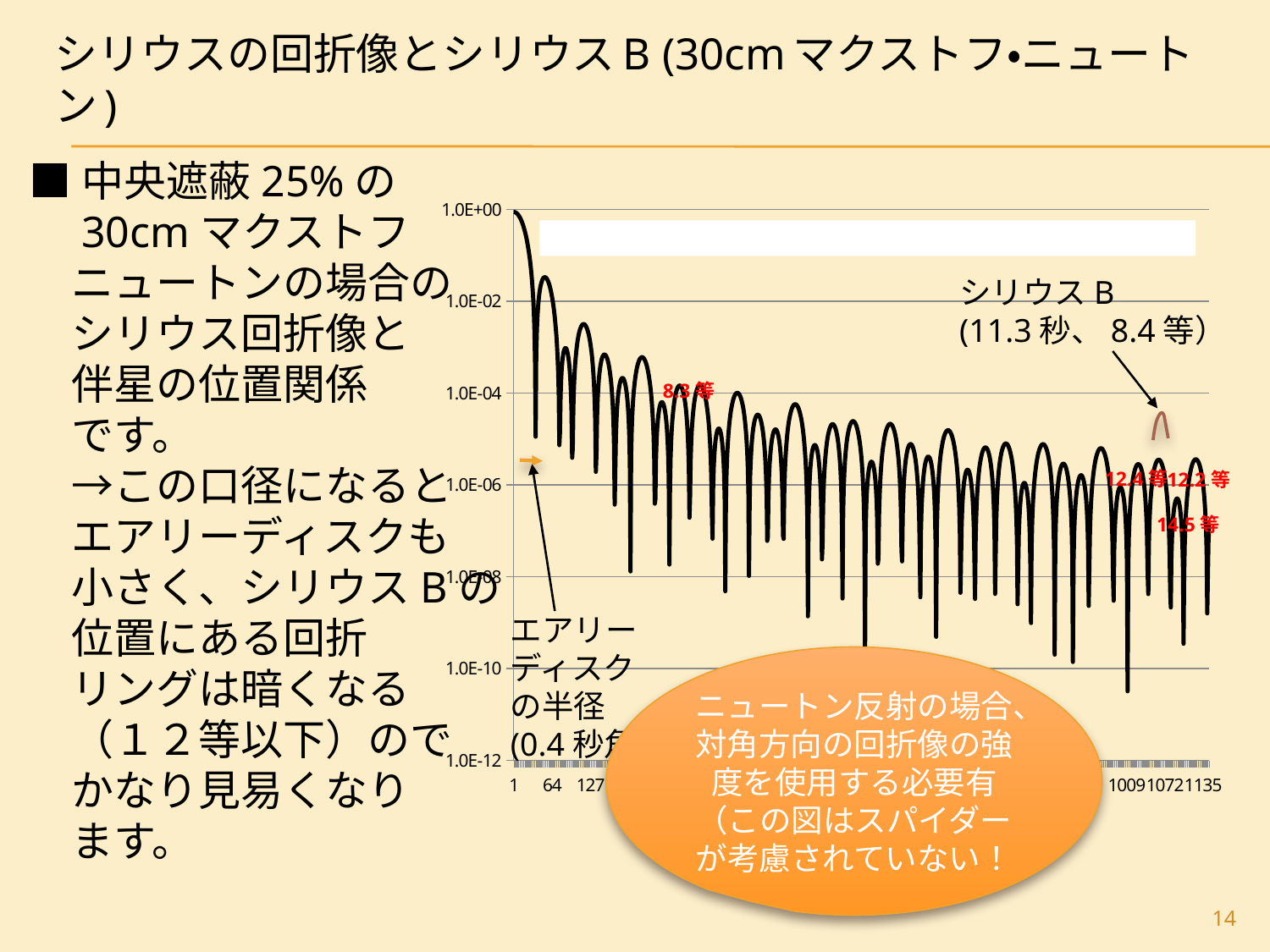
What is the highest value shown on the y axis of the chart? 1.0E+00 What kind of chart is shown on the slide? line chart Are the peaks of the curve near the position marked シリウス B greater or less than 1.0E-04? less According to the annotation on the chart, what is the separation and magnitude of シリウス B? 11.3 秒、8.4 等 Is the value of the curve at x = 1 greater or less than 1.0E-02? greater What is the first tick label on the x axis of the chart? 1 How many labelled tick values are shown on the y axis of the chart? 7 According to the annotation on the chart, what is the radius of the Airy disk (エアリーディスクの半径)? 0.4 秒角 What is the last tick label on the x axis of the chart? 1135 What is the lowest value shown on the y axis of the chart? 1.0E-12 Do the peak values of the diffraction pattern generally rise or fall as you move from left to right along the x axis? fall What magnitude is written in red near the left part of the curve, around the 1.0E-04 level? 8.3 等